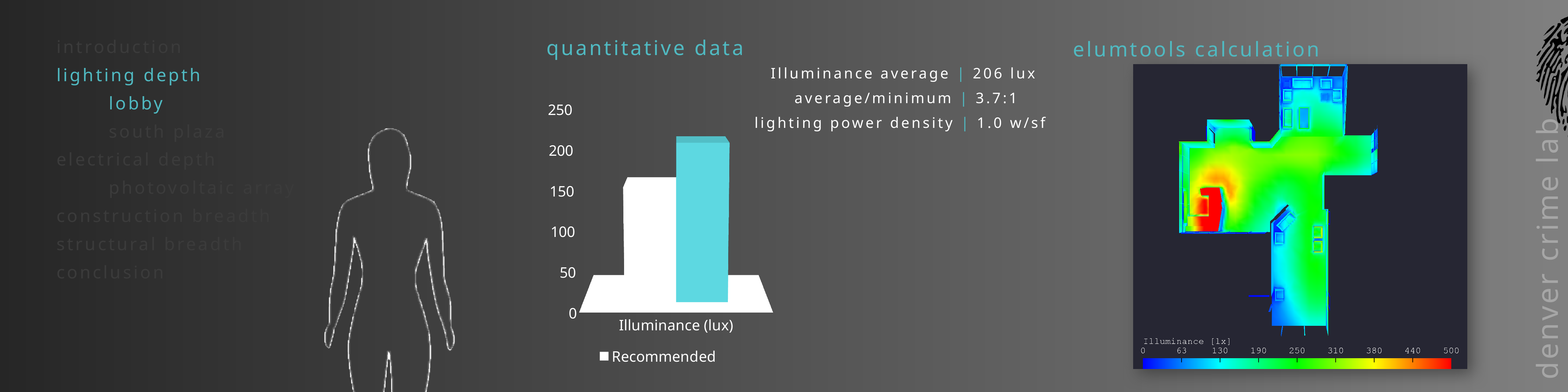
What is the highest tick value shown on the vertical axis of the bar chart? 250 What series name does the legend of the bar chart show? Recommended How many categories are shown on the x axis of the bar chart? 1 Is the value of the white Recommended bar greater or less than 100? greater What is the category label on the x axis of the bar chart? Illuminance (lux) How many bars are plotted in the bar chart? 2 Is the value of the white Recommended bar greater or less than 200? less Is the value of the teal bar greater or less than 250? less What kind of chart is shown under the heading "quantitative data"? bar chart Which bar is taller in the bar chart, the white Recommended bar or the teal bar? the teal bar